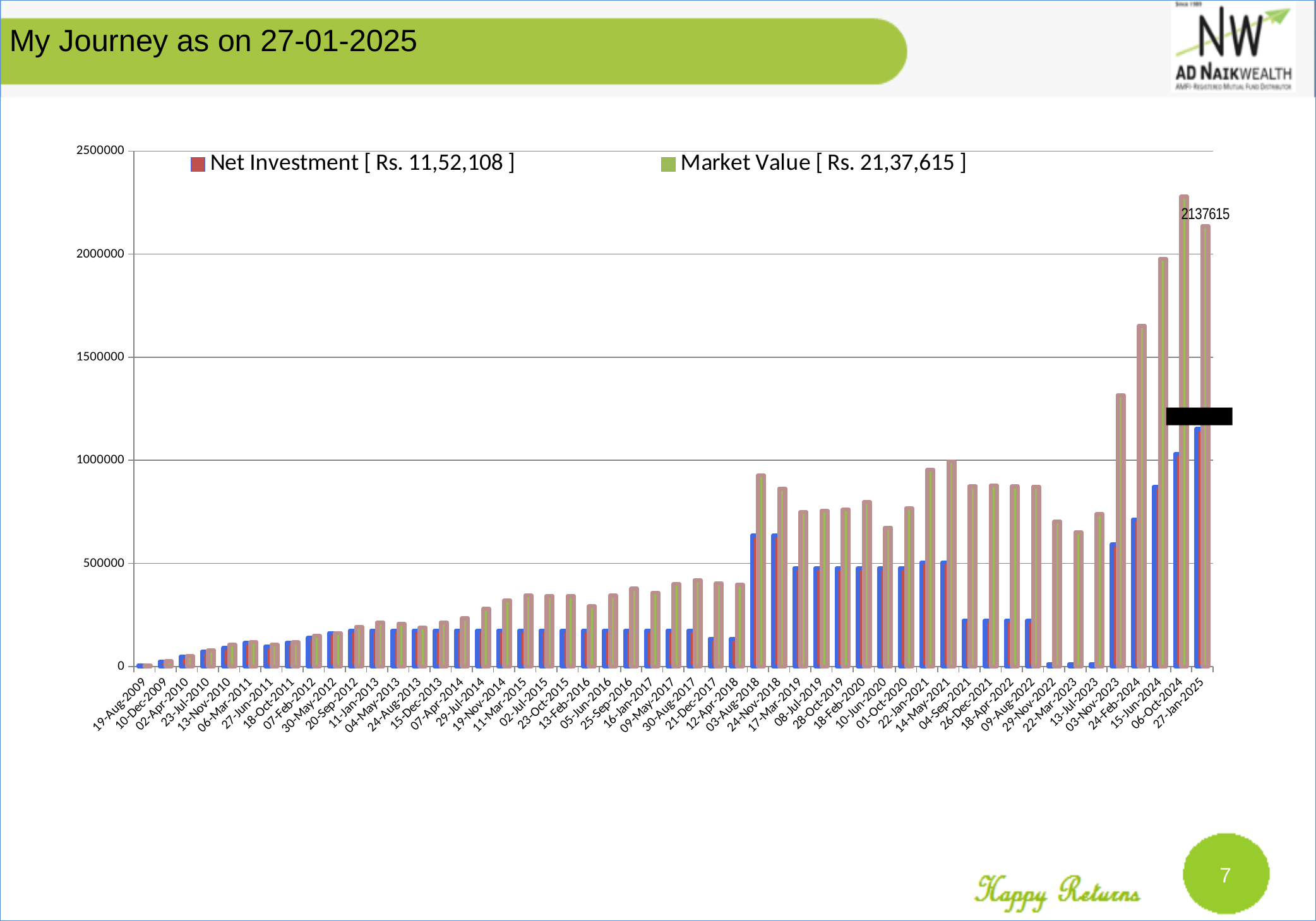
What type of chart is shown on the slide? bar chart What is the Market Value data label shown for 27-Jan-2025? 2137615 How many series does the chart legend list? 2 Which is larger for 24-Feb-2024: the Net Investment or the Market Value? Market Value Is the Market Value for 03-Aug-2018 greater or less than 500000? greater Which date has the lowest Market Value bar? 19-Aug-2009 What Market Value amount is shown in the chart legend? Rs. 21,37,615 Is the Net Investment for 27-Jan-2025 greater or less than 1000000? greater Is the Net Investment for 04-Sep-2021 greater or less than 500000? less Which date has the highest Market Value bar? 06-Oct-2024 What Net Investment amount is shown in the chart legend? Rs. 11,52,108